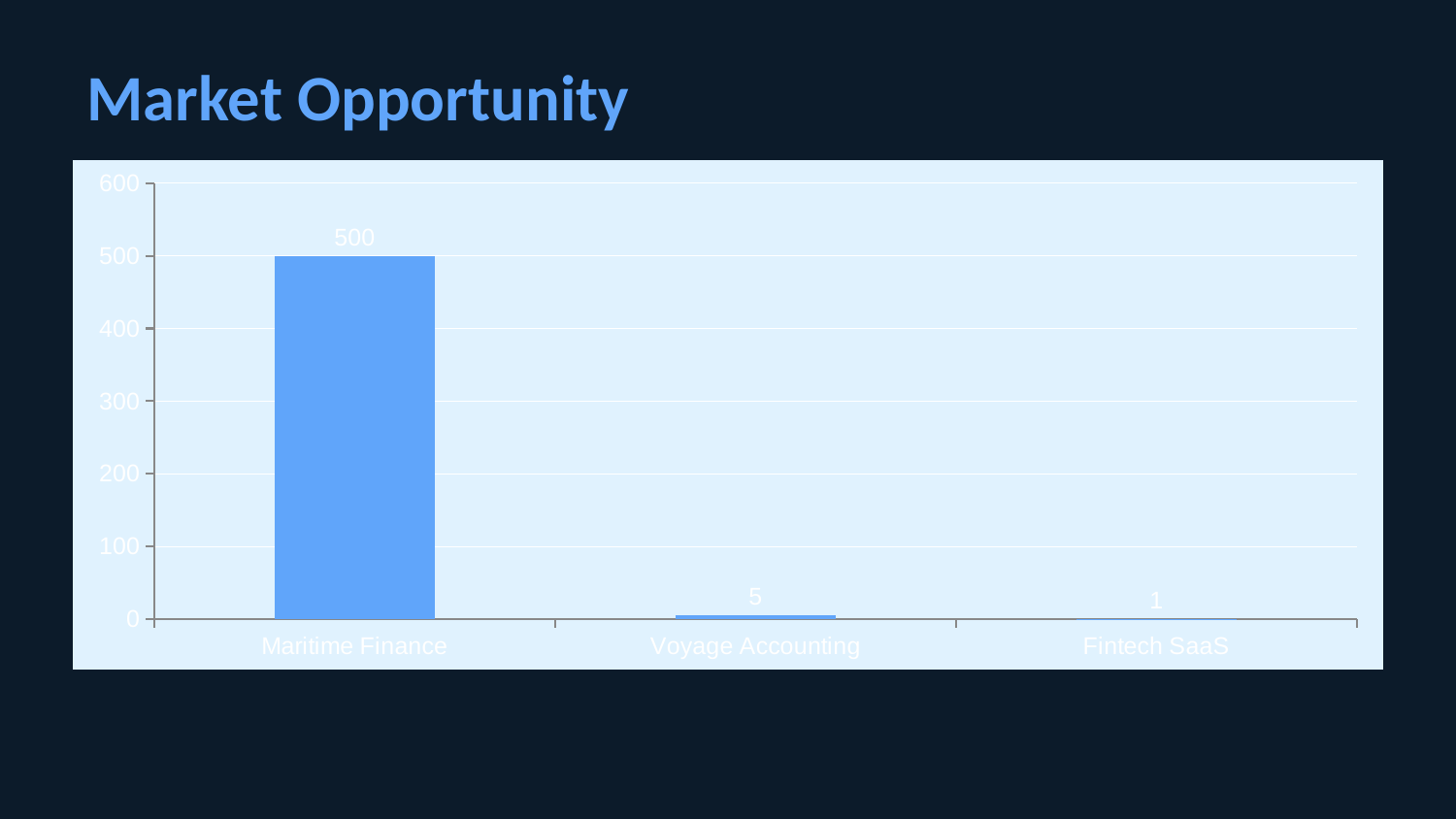
Which category has the highest value? Maritime Finance Is the value for Maritime Finance greater or less than 400? greater What is the difference between the values for Maritime Finance and Voyage Accounting? 495 What is the value for Voyage Accounting? 5 What is the title of the slide containing the chart? Market Opportunity What is the value for Maritime Finance? 500 Which is larger, the value for Voyage Accounting or the value for Fintech SaaS? Voyage Accounting How many categories are shown on the x axis? 3 Which category has the lowest value? Fintech SaaS What kind of chart is shown on the slide? bar chart What is the difference between the values for Voyage Accounting and Fintech SaaS? 4 What is the value for Fintech SaaS? 1